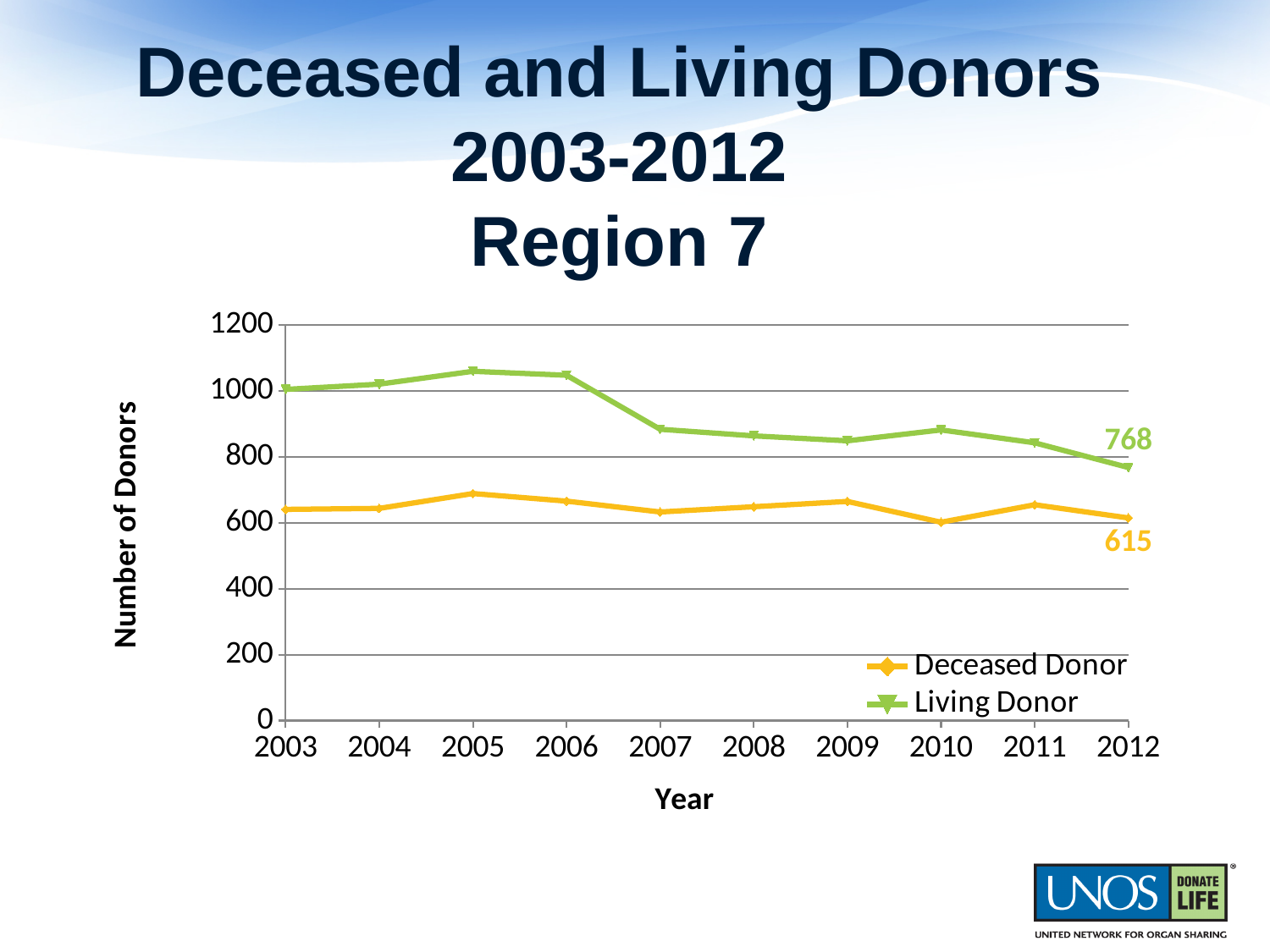
Is the value for Deceased Donor in 2010 greater or less than 800? less What is the value for Living Donor in 2012? 768 What kind of chart is shown on the slide? Line chart What is the difference between the Living Donor and Deceased Donor values in 2012? 153 How many series does the legend list? 2 Is the value for Living Donor in 2005 greater or less than 1000? greater What is the title of the y axis? Number of Donors How many years are shown on the x axis? 10 What is the value for Deceased Donor in 2012? 615 In which year is the Living Donor value lowest? 2012 Does the Living Donor line rise or fall from 2003 to 2012? Fall In 2012, which series has the larger value, Living Donor or Deceased Donor? Living Donor